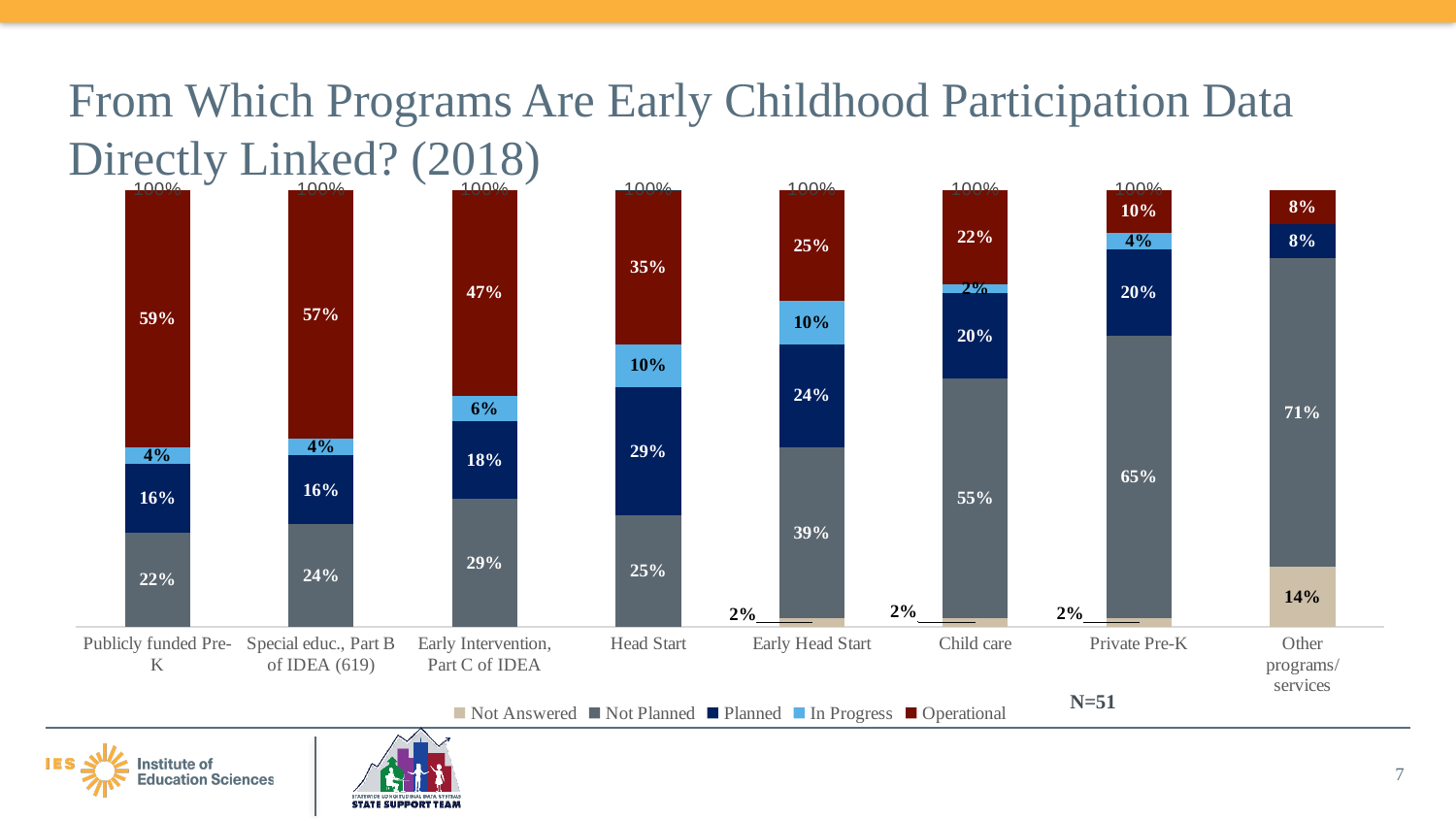
What is the Not Planned value for Other programs/services? 71% Which is larger: the Operational value for Head Start or the Operational value for Early Head Start? Head Start How many series does the legend list? 5 What is the In Progress value for Early Intervention, Part C of IDEA? 6% What is the difference between the Not Planned values for Private Pre-K and Child care? 10% How many program categories are shown along the x axis? 8 What sample size (N) is stated on the slide? N=51 What is the Operational value for Publicly funded Pre-K? 59% What is the Planned value for Head Start? 29% What kind of chart is shown on the slide? Stacked bar chart Which program has the highest Operational value? Publicly funded Pre-K Which program has the lowest Not Planned value? Publicly funded Pre-K